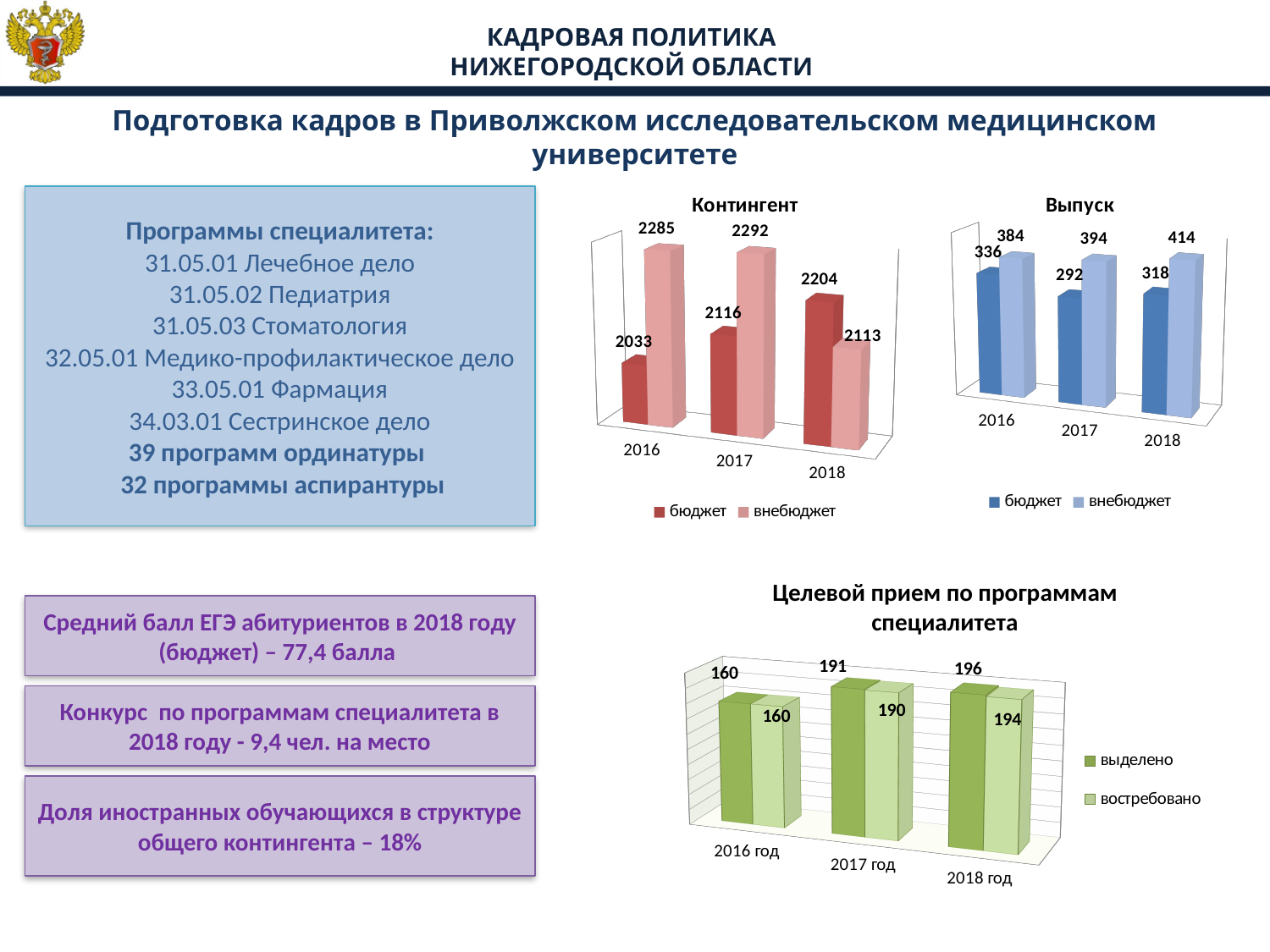
In the 'Целевой прием по программам специалитета' chart, what is the value for востребовано in 2017 год? 190 In the 'Контингент' chart, does the бюджет series rise or fall from 2016 to 2018? rise How many series does the legend of the 'Целевой прием по программам специалитета' chart list? 2 In the 'Контингент' chart, what is the difference between внебюджет and бюджет in 2016? 252 In the 'Выпуск' chart, which is larger in 2016: бюджет or внебюджет? внебюджет What type of chart is the 'Выпуск' chart? bar chart In the 'Целевой прием по программам специалитета' chart, what is the difference between выделено and востребовано in 2018 год? 2 In the 'Контингент' chart, what is the value for внебюджет in 2016? 2285 In the 'Выпуск' chart, what is the value for внебюджет in 2018? 414 In the 'Контингент' chart, what is the value for бюджет in 2018? 2204 In the 'Выпуск' chart, which year has the lowest бюджет value? 2017 In the 'Контингент' chart, which year has the highest внебюджет value? 2017